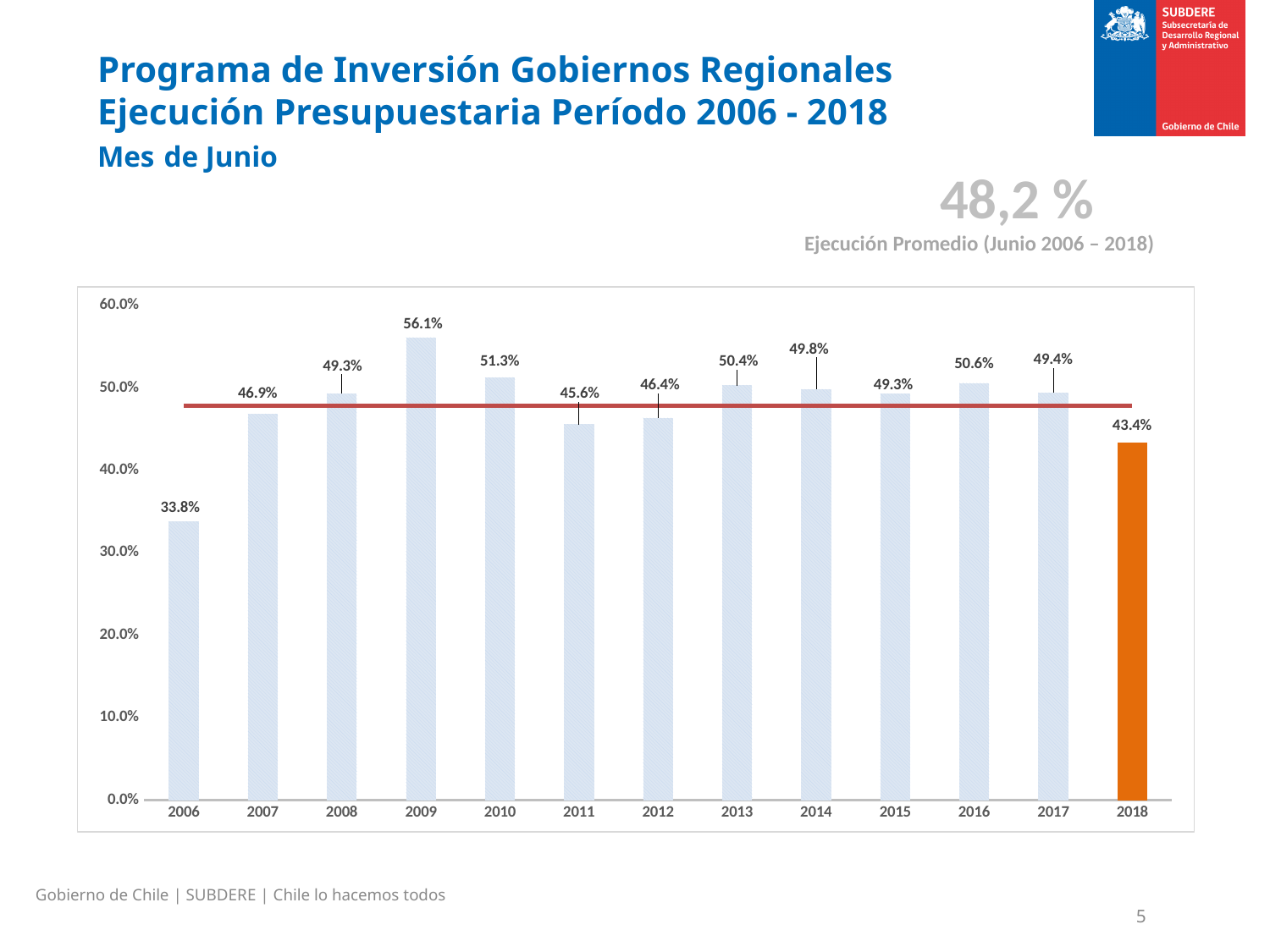
How many years are shown on the x axis? 13 Which is larger, the value for 2013 or the value for 2011? 2013 What is the value for 2018? 43.4% Which year has the lowest value? 2006 What is the value for 2006? 33.8% What is the average execution value shown above the chart for June 2006–2018? 48,2 % Which year's bar is coloured orange? 2018 Is the value for 2012 greater or less than 50.0%? less What kind of chart is this? bar chart What is the difference between the values for 2009 and 2018? 12.7% What is the value for 2009? 56.1% Which year has the highest value? 2009